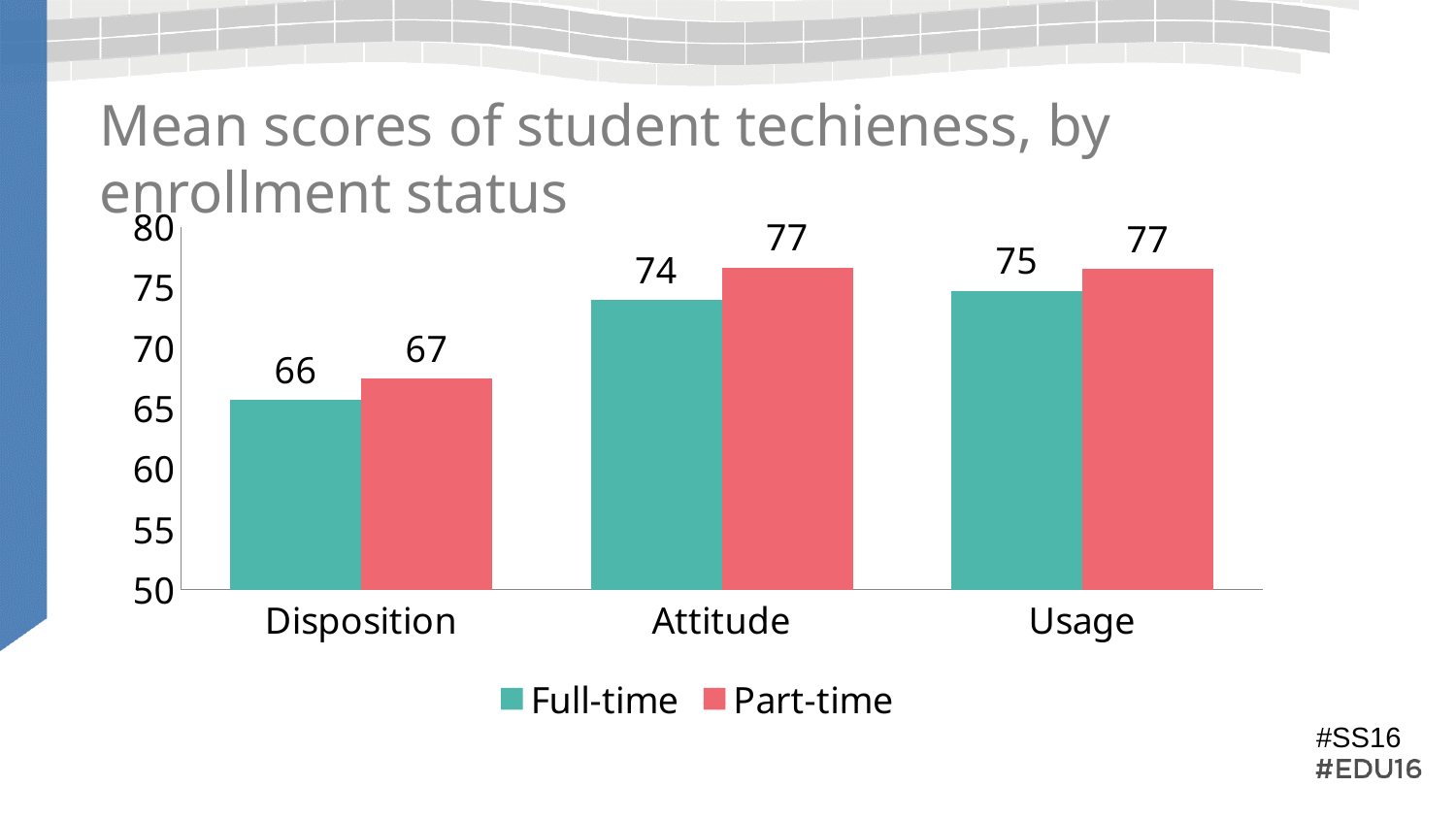
How many series does the legend list? 2 What is the Full-time mean score for Usage? 75 What is the Full-time mean score for Disposition? 66 Which is larger for Usage, the Full-time score or the Part-time score? Part-time What is the difference between the Part-time and Full-time scores for Attitude? 3 What is the title of the chart? Mean scores of student techieness, by enrollment status What is the difference between the Part-time and Full-time scores for Disposition? 1 What kind of chart is shown on the slide? Bar chart Which category has the lowest Full-time score? Disposition How many categories are shown on the x axis? 3 Which category has the lowest Part-time score? Disposition What is the Part-time mean score for Attitude? 77